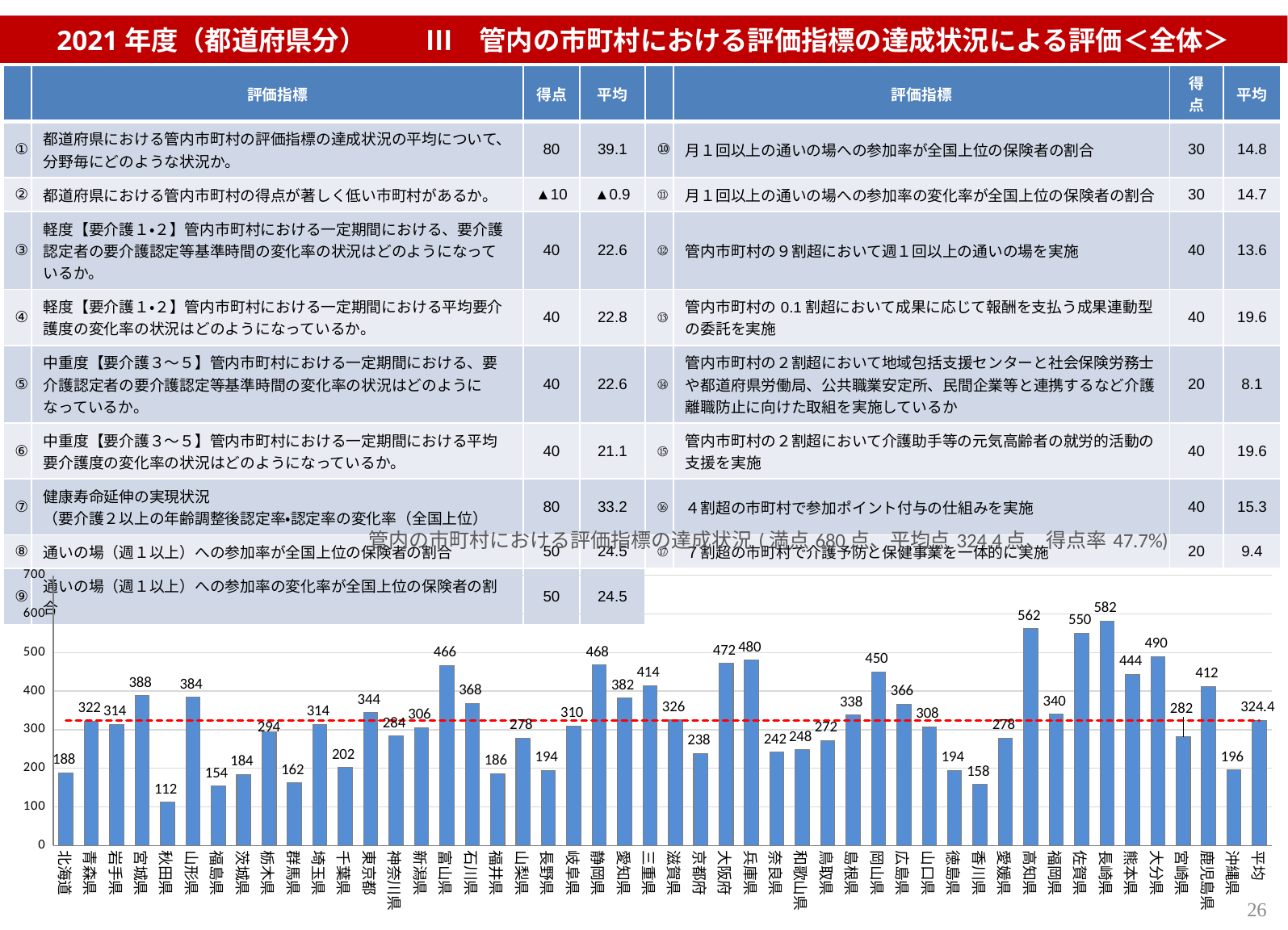
What is the value for 長崎県 in the bar chart? 582 What is the value for 東京都 in the bar chart? 344 What is the value for 秋田県 in the bar chart? 112 What is the difference between the values for 高知県 and 佐賀県? 12 What kind of chart is shown at the bottom of the slide? bar chart How many prefecture bars are plotted in the chart, excluding the 平均 bar? 47 Which prefecture has the highest bar in the chart? 長崎県 What is the value of the 平均 bar at the right end of the chart? 324.4 Is the value for 富山県 greater or less than 400? greater Which prefecture has the lowest bar in the chart? 秋田県 What does the red dashed horizontal line across the chart represent? 平均点 324.4 Which is larger, the value for 大阪府 or the value for 兵庫県? 兵庫県